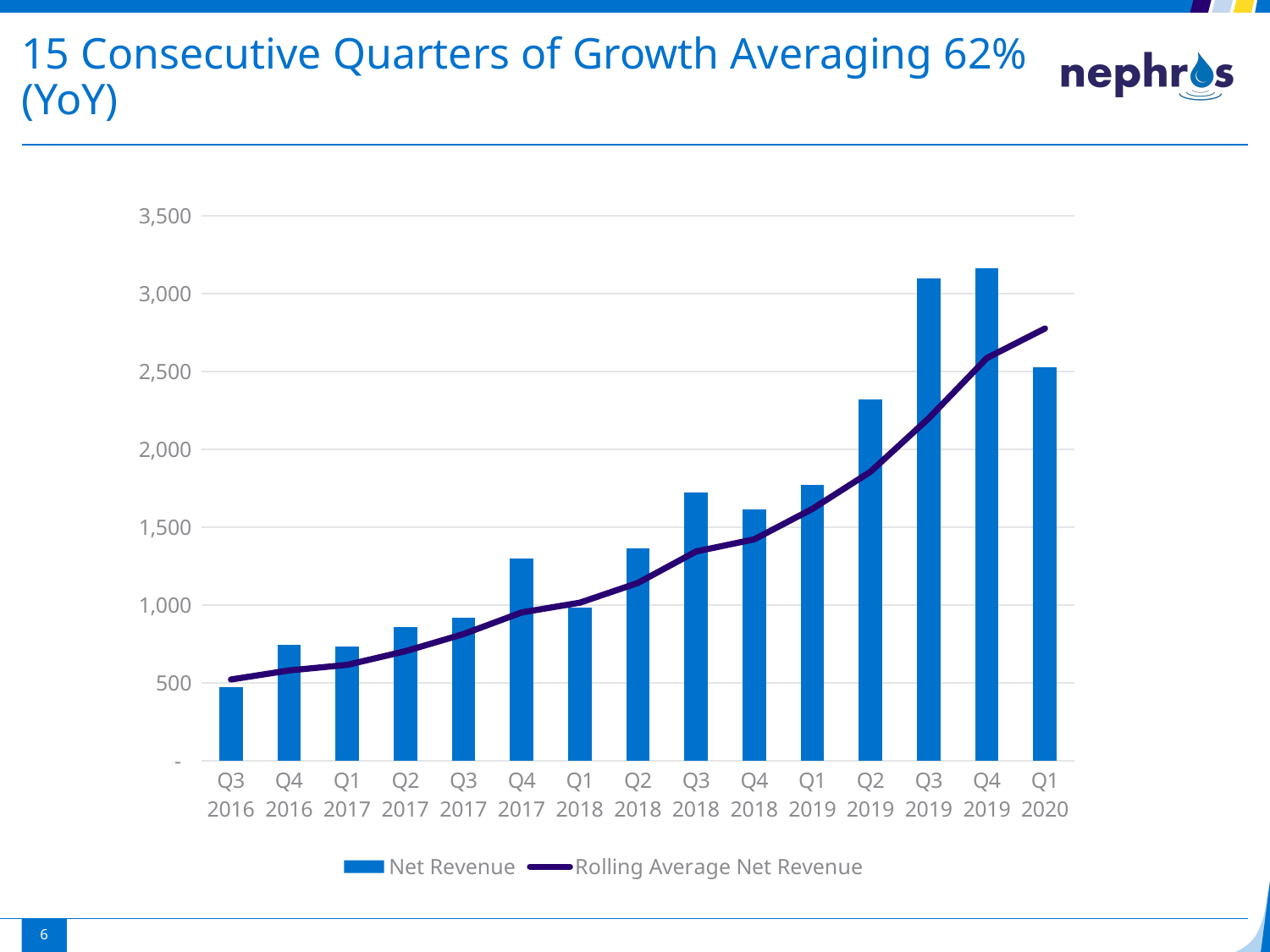
Is the Net Revenue for Q4 2017 greater or less than 1,500? less Does the Rolling Average Net Revenue line rise or fall from Q3 2016 to Q1 2020? Rise Which quarter has the highest Net Revenue bar? Q4 2019 How many series does the legend list? 2 Which has the larger Net Revenue, Q3 2018 or Q4 2018? Q3 2018 Which quarter has the lowest Net Revenue bar? Q3 2016 What kind of chart is shown on the slide? Bar chart with a line Which has the larger Net Revenue, Q4 2019 or Q1 2020? Q4 2019 How many quarters are plotted along the x axis? 15 Is the Net Revenue for Q4 2016 greater or less than 1,000? less Is the Net Revenue for Q1 2020 greater or less than 2,000? greater